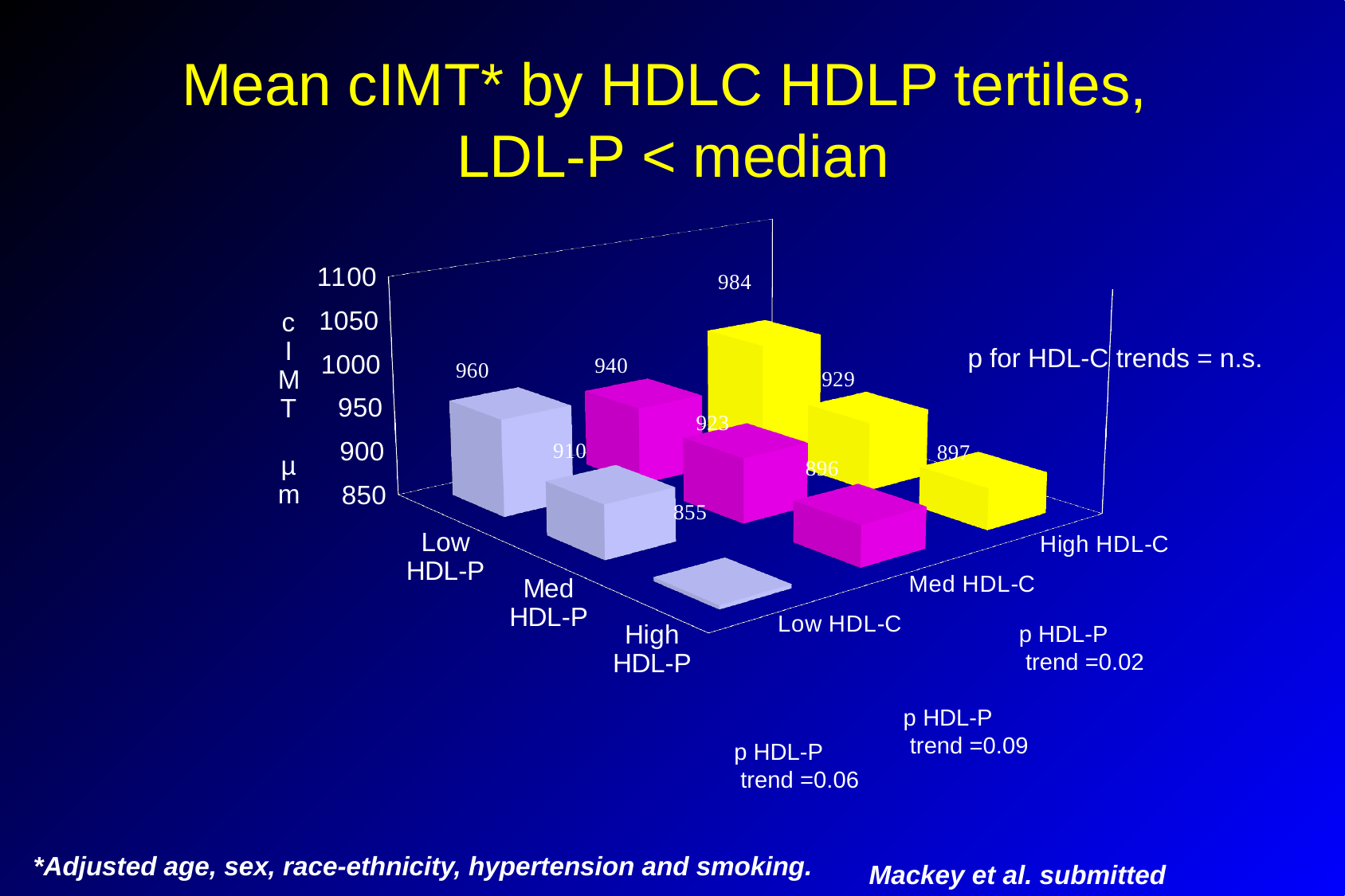
What is the mean cIMT for High HDL-P with Low HDL-C? 855 What is the mean cIMT for Med HDL-P with Med HDL-C? 923 What type of chart is shown on the slide? Bar chart What is the difference in mean cIMT between Low HDL-P and High HDL-P within the Low HDL-C group? 105 Which combination of HDL-P and HDL-C tertiles has the lowest mean cIMT? High HDL-P, Low HDL-C Within the Med HDL-C group, which has the larger mean cIMT: Low HDL-P or High HDL-P? Low HDL-P How many HDL-P tertile categories are shown on the chart? 3 Within each HDL-C group, do mean cIMT values rise or fall from Low HDL-P to High HDL-P? Fall What is the difference in mean cIMT between Low HDL-P and High HDL-P within the High HDL-C group? 87 What is the mean cIMT for Low HDL-P with Low HDL-C? 960 What is the mean cIMT for Low HDL-P with High HDL-C? 984 Which combination of HDL-P and HDL-C tertiles has the highest mean cIMT? Low HDL-P, High HDL-C